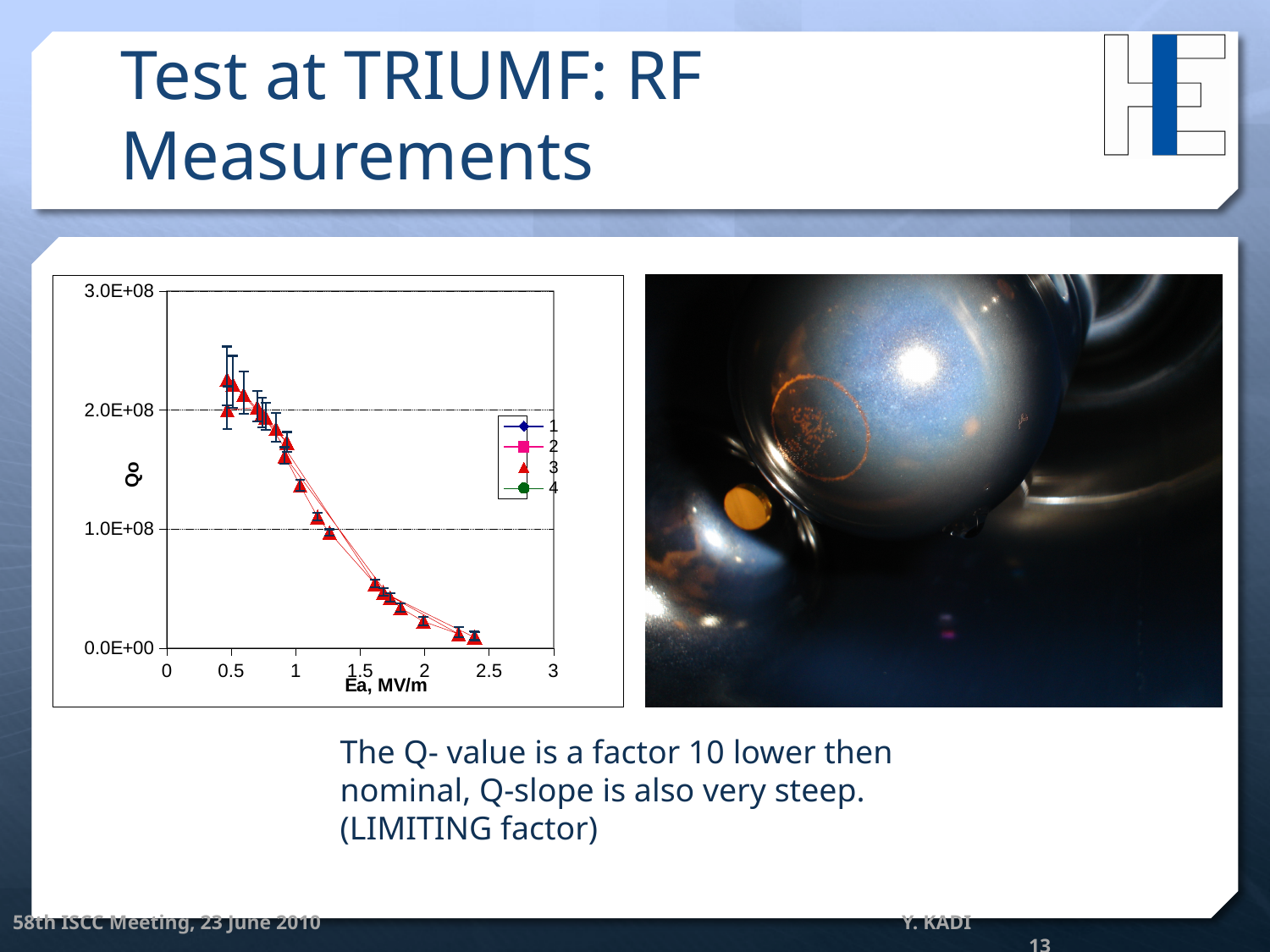
Is the Qo value at Ea = 0.5 MV/m greater or less than 1.0E+08? greater How many series does the chart's legend list? 4 Does Qo rise or fall as Ea increases along the x axis? fall What are the series names listed in the chart's legend? 1, 2, 3, 4 Which has the larger Qo value: the point at Ea = 0.5 MV/m or the point at Ea = 2 MV/m? Ea = 0.5 MV/m What kind of chart is shown on the slide? scatter (line) chart with error bars Is the Qo value at Ea = 2 MV/m greater or less than 1.0E+08? less Is the Qo value at Ea = 0.5 MV/m greater or less than 3.0E+08? less What is the label of the x axis of the chart? Ea, MV/m